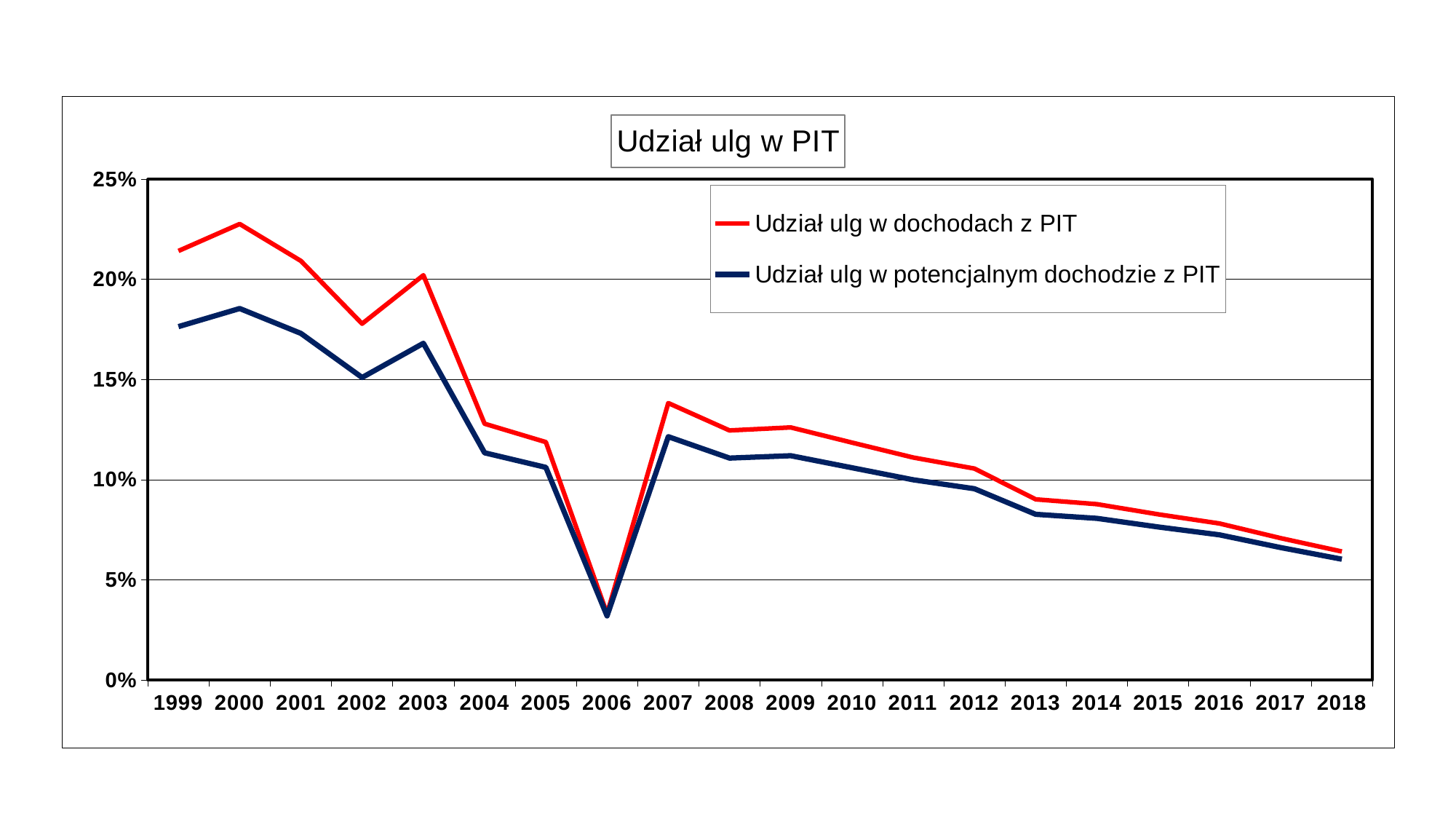
Is the value for 'Udział ulg w dochodach z PIT' in 2006 greater or less than 5%? less Which colour is used for the series 'Udział ulg w potencjalnym dochodzie z PIT'? dark blue Is the value for 'Udział ulg w dochodach z PIT' in 2002 greater or less than 15%? greater What kind of chart is shown on the slide? line chart Is the value for 'Udział ulg w potencjalnym dochodzie z PIT' in 2013 greater or less than 10%? less How many years are plotted along the x axis? 20 What is the title of the chart? Udział ulg w PIT In which year does the series 'Udział ulg w potencjalnym dochodzie z PIT' reach its lowest value? 2006 How many series does the legend list? 2 In which year does the series 'Udział ulg w dochodach z PIT' reach its highest value? 2000 Overall, do the values of 'Udział ulg w dochodach z PIT' rise or fall from 1999 to 2018? fall In 2003, which series has the larger value: 'Udział ulg w dochodach z PIT' or 'Udział ulg w potencjalnym dochodzie z PIT'? Udział ulg w dochodach z PIT